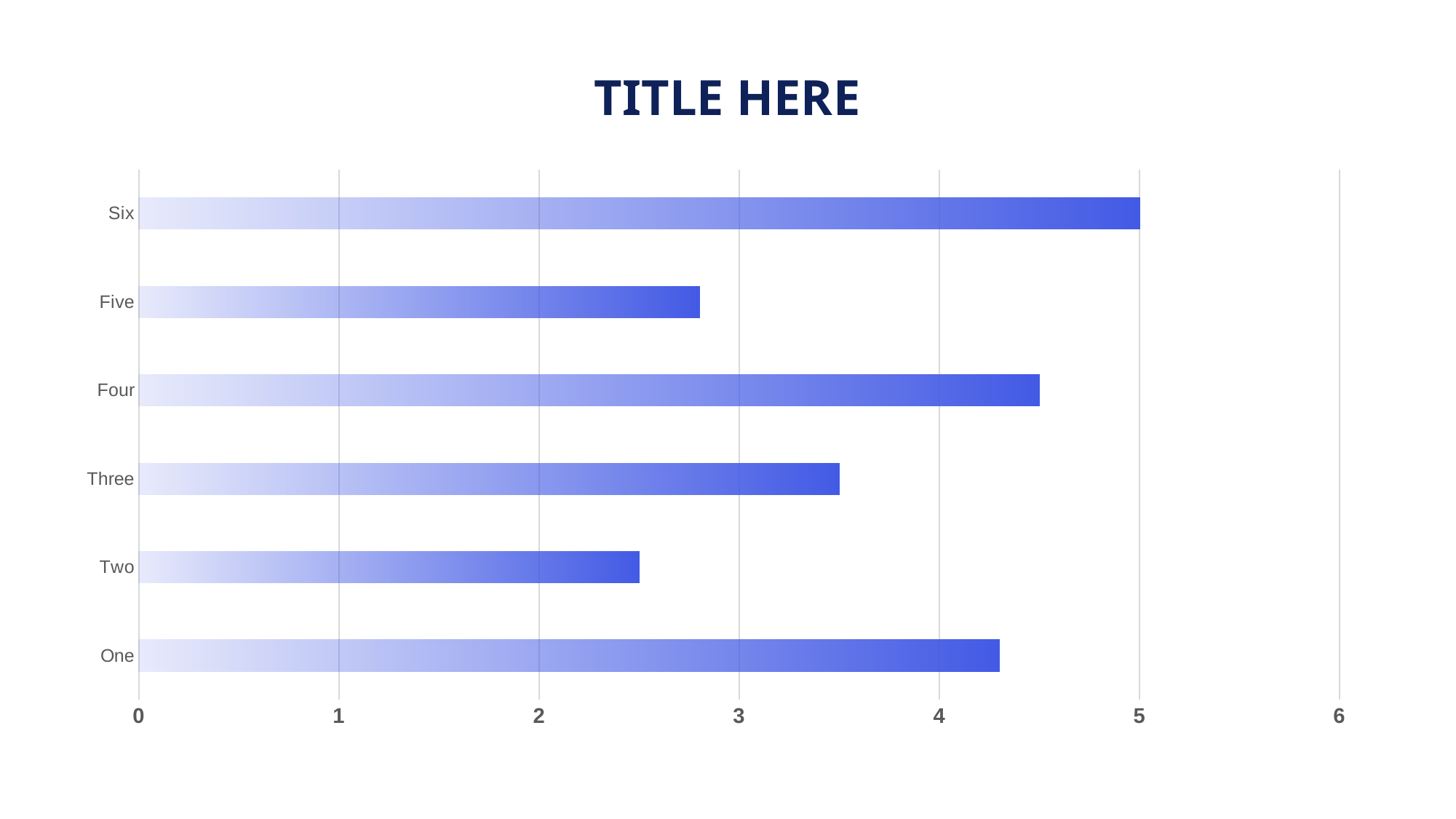
Is the value for One greater or less than 4? greater Which category has the highest value? Six What is the value for Six? 5 How many categories are plotted in the chart? 6 What kind of chart is shown on the slide? bar chart Is the value for Three greater or less than 3? greater Which is larger, the value for Three or the value for Five? Three Is the value for Five greater or less than 3? less What is the title of the chart? TITLE HERE Which category has the lowest value? Two Which is larger, the value for Four or the value for Two? Four